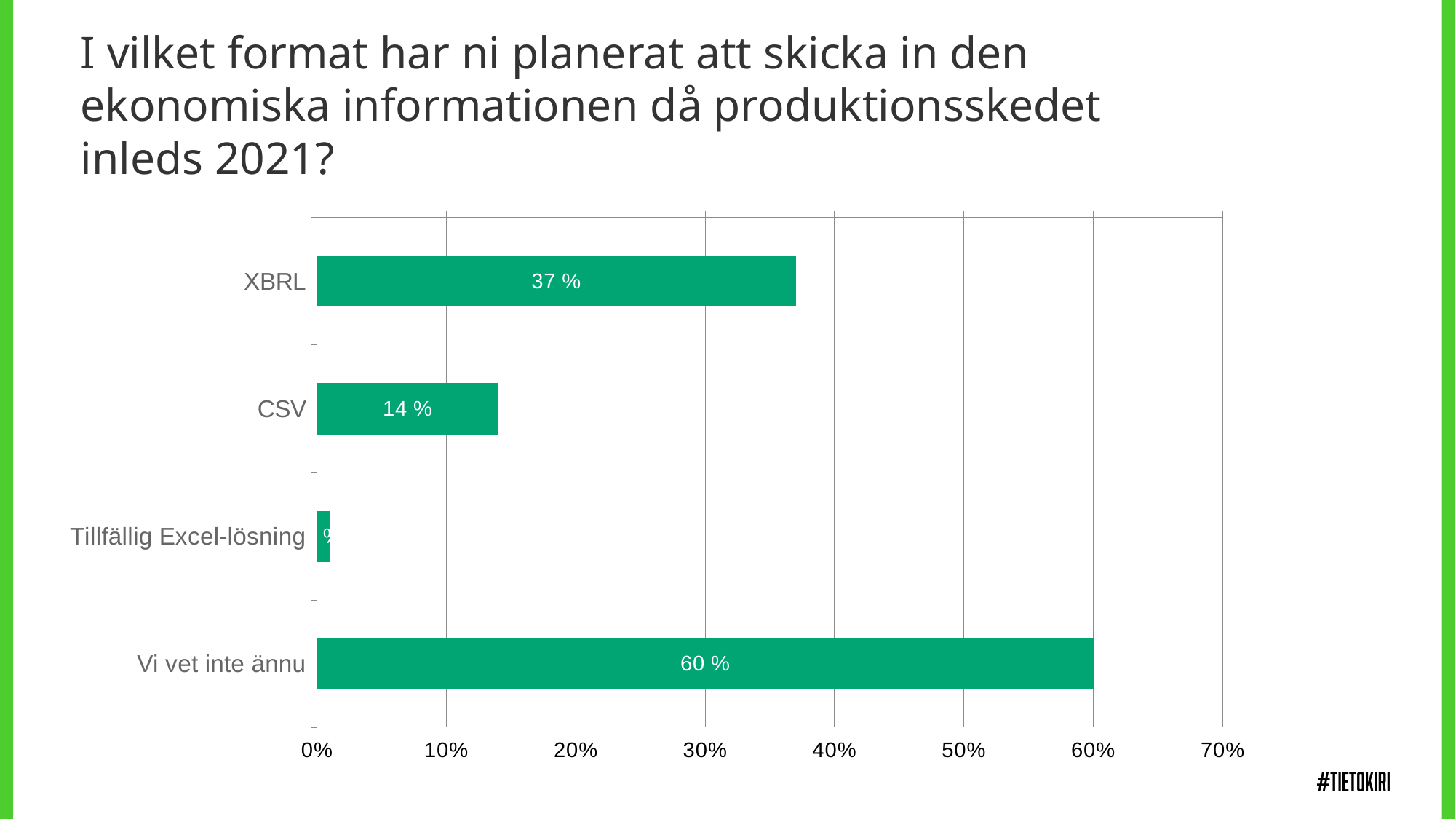
Which is larger, the value for XBRL or the value for CSV? XBRL What is the value for XBRL? 37 % What kind of chart is shown on the slide? bar chart What is the value for CSV? 14 % Which category has the highest value? Vi vet inte ännu What is the value for Vi vet inte ännu? 60 % What is the difference between the values for Vi vet inte ännu and XBRL? 23 % How many categories are shown in the chart? 4 What is the difference between the values for XBRL and CSV? 23 % What is the highest value shown on the x axis? 70% Which category has the lowest value? Tillfällig Excel-lösning Is the value for Tillfällig Excel-lösning greater or less than 10%? less